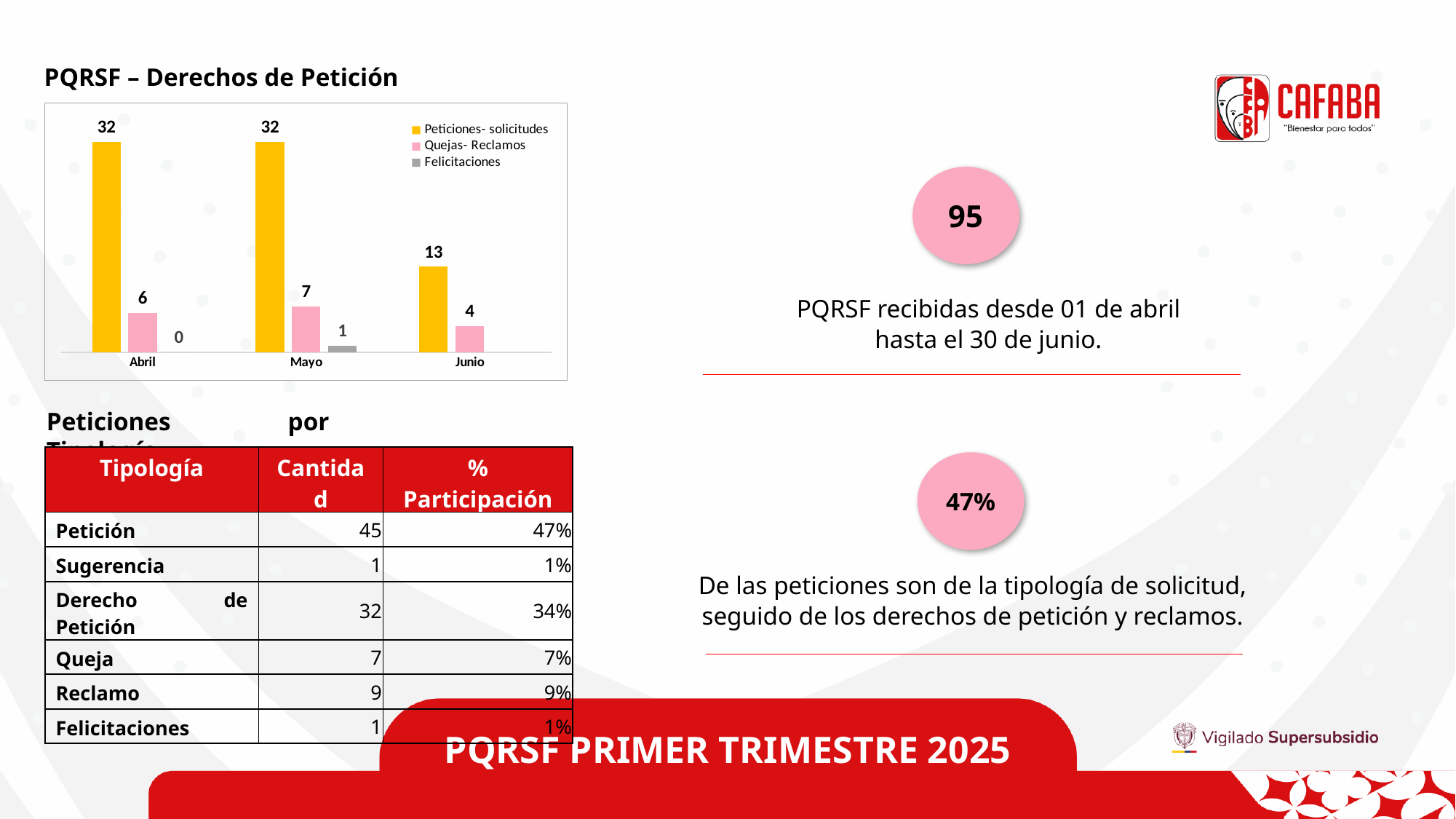
What is the difference between Peticiones- solicitudes in Mayo and in Junio? 19 What is the value for Quejas- Reclamos in Mayo? 7 Which month has the highest value for Quejas- Reclamos? Mayo Which series is shown in yellow in the chart? Peticiones- solicitudes Which month has the lowest value for Peticiones- solicitudes? Junio Which is larger: Quejas- Reclamos in Abril or Quejas- Reclamos in Junio? Quejas- Reclamos in Abril What is the value for Peticiones- solicitudes in Junio? 13 How many months are shown on the x axis of the chart? 3 What is the value for Felicitaciones in Abril? 0 What is the value for Peticiones- solicitudes in Abril? 32 How many series does the chart legend list? 3 What type of chart is shown on the slide? bar chart